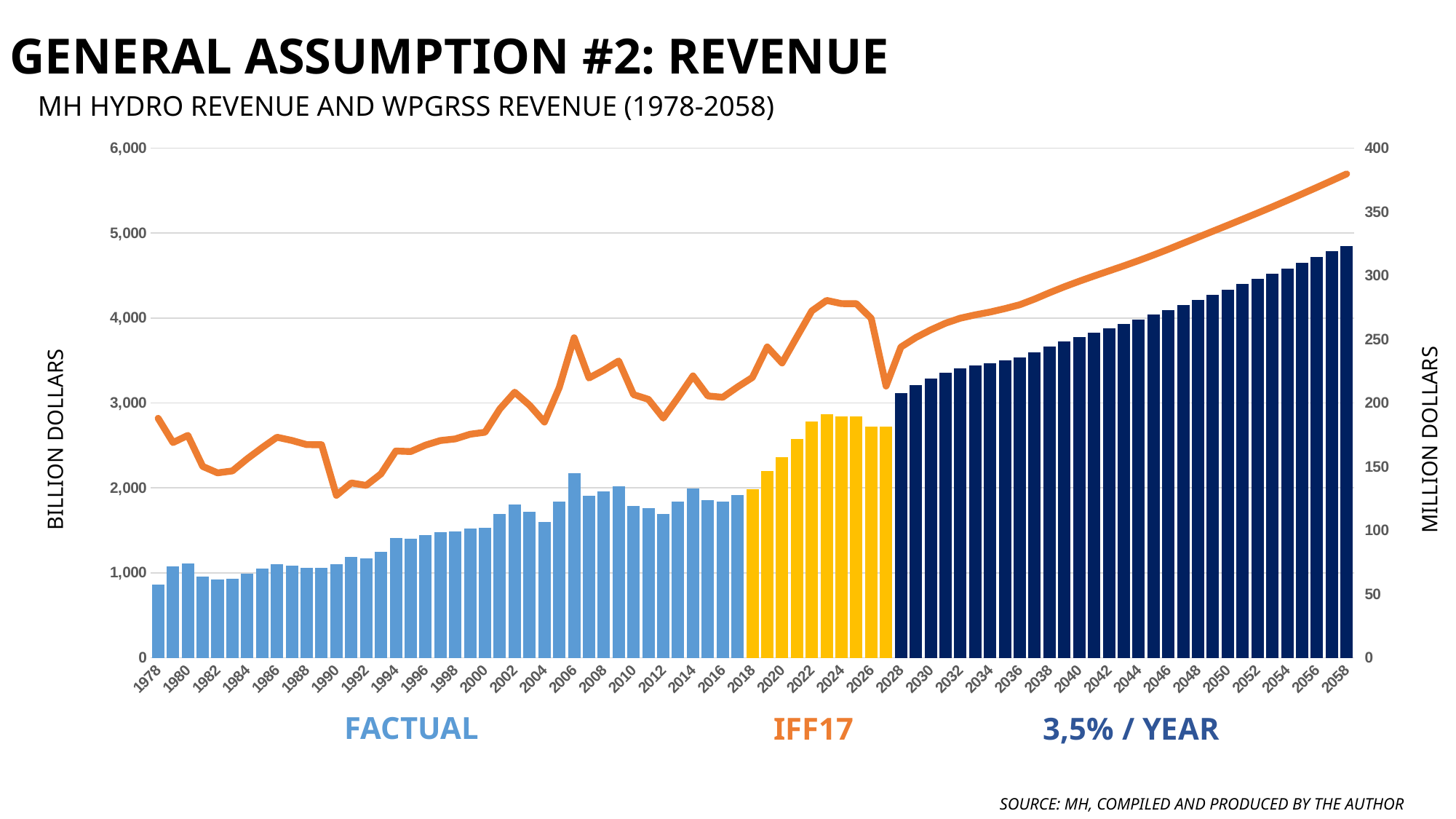
Is the bar value for 2006 greater or less than 2,000 on the left axis? greater Does the orange line rise or fall from 2028 to 2058? rise Which bar is taller, 2004 or 2006? 2006 What is the title of the chart? MH HYDRO REVENUE AND WPGRSS REVENUE (1978-2058) Is the orange line value for 1990 greater or less than 150 on the right axis? less Do the bar values rise or fall from 2028 to 2058? rise What are the labels of the left and right vertical axes? BILLION DOLLARS (left) and MILLION DOLLARS (right) Which year has the tallest bar? 2058 What kind of chart is shown on the slide? A combined bar and line chart Is the bar value for 2058 greater or less than 4,000 on the left axis? greater